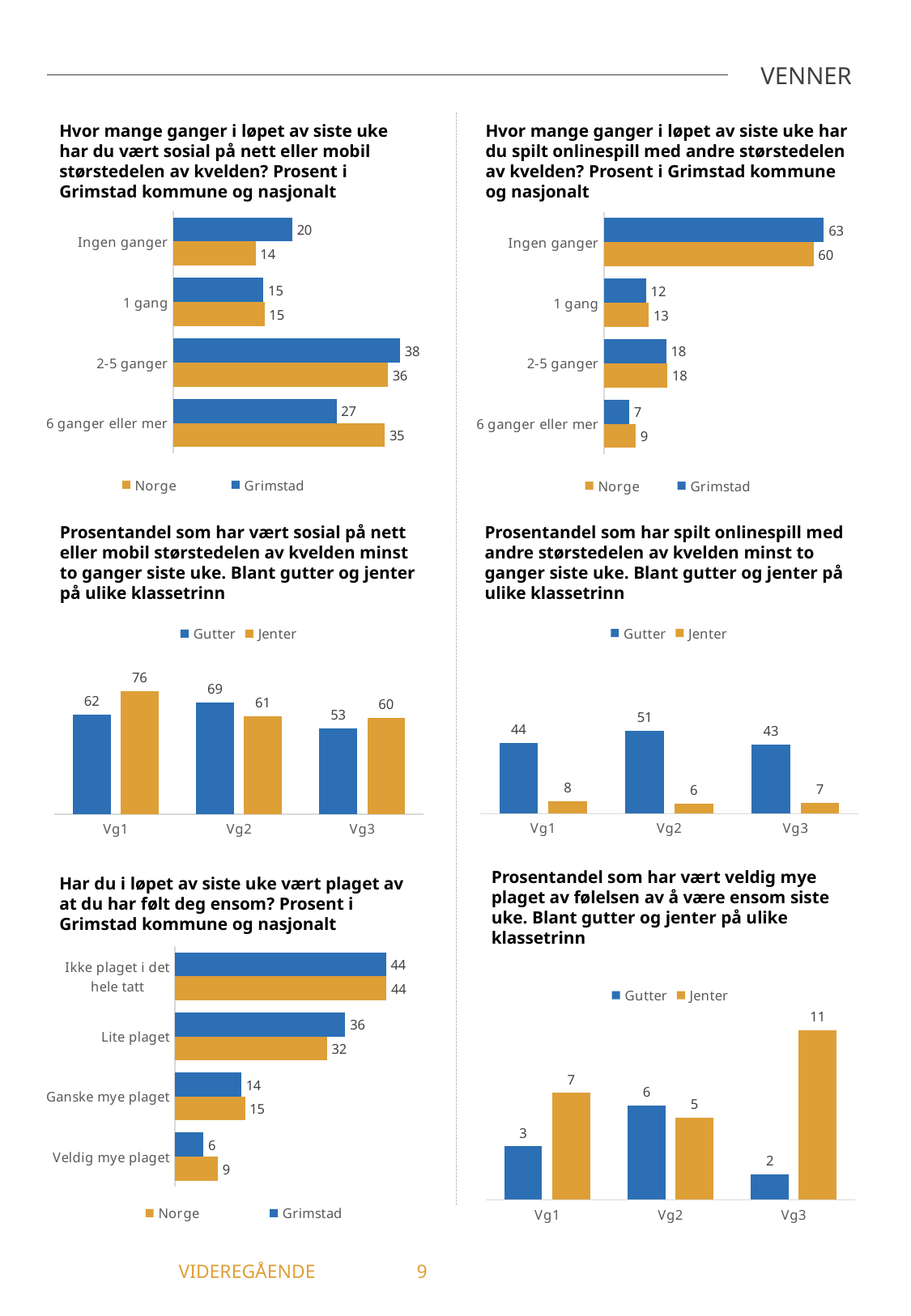
In the bottom-left chart (plaget av å føle deg ensom), what is the value for Norge in the 'Lite plaget' category? 32 In the middle-right chart (spilt onlinespill minst to ganger), what is the difference between Gutter and Jenter at Vg1? 36 In the middle-right chart (spilt onlinespill minst to ganger), which class level has the highest value for Gutter? Vg2 What type of chart is the bottom-right chart (veldig mye plaget av ensomhet)? Bar chart In the middle-left chart (sosial på nett minst to ganger), which group has the higher value at Vg1, Gutter or Jenter? Jenter In the bottom-right chart (veldig mye plaget av ensomhet), which class level has the lowest value for Gutter? Vg3 In the top-left chart (sosial på nett eller mobil), what is the difference between Norge and Grimstad for '6 ganger eller mer'? 8 In the middle-left chart (sosial på nett minst to ganger), what is the value for Gutter at Vg3? 53 In the top-right chart (spilt onlinespill), which category has the highest value for Grimstad? Ingen ganger In the top-right chart (spilt onlinespill), what is the value for Norge in the '6 ganger eller mer' category? 9 In the top-left chart (sosial på nett eller mobil), what is the value for Grimstad in the '2-5 ganger' category? 38 In the top-right chart (spilt onlinespill), how many categories are shown? 4